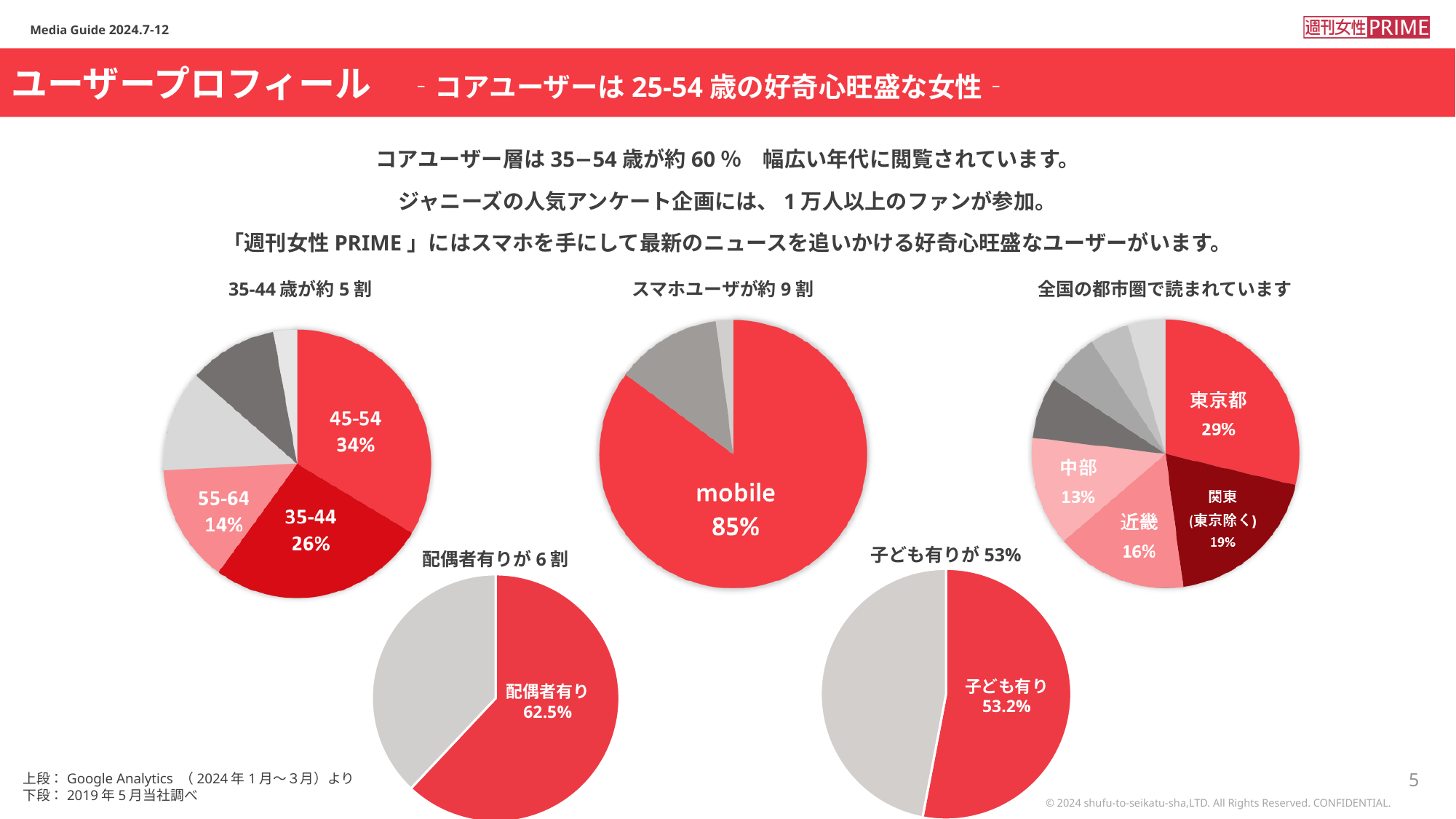
In the chart titled 「スマホユーザが約9割」, what percentage is shown for mobile? 85% In the chart titled 「35-44歳が約5割」, what percentage is shown for the 45-54 age group? 34% In the chart titled 「35-44歳が約5割」, what percentage is shown for the 55-64 age group? 14% In the chart titled 「35-44歳が約5割」, what percentage is shown for the 35-44 age group? 26% In the chart titled 「全国の都市圏で読まれています」, what percentage is shown for 東京都? 29% In the chart titled 「35-44歳が約5割」, which labeled age group has the largest slice? 45-54 In the chart titled 「全国の都市圏で読まれています」, which is larger, 近畿 or 中部? 近畿 In the chart titled 「全国の都市圏で読まれています」, what percentage is shown for 関東(東京除く)? 19% In the chart titled 「子ども有りが53%」, what percentage is shown for 子ども有り? 53.2% What kind of chart is used for the chart titled 「スマホユーザが約9割」? Pie chart In the chart titled 「35-44歳が約5割」, what is the difference in percentage points between the 45-54 and 35-44 slices? 8 In the chart titled 「配偶者有りが6割」, what percentage is shown for 配偶者有り? 62.5%